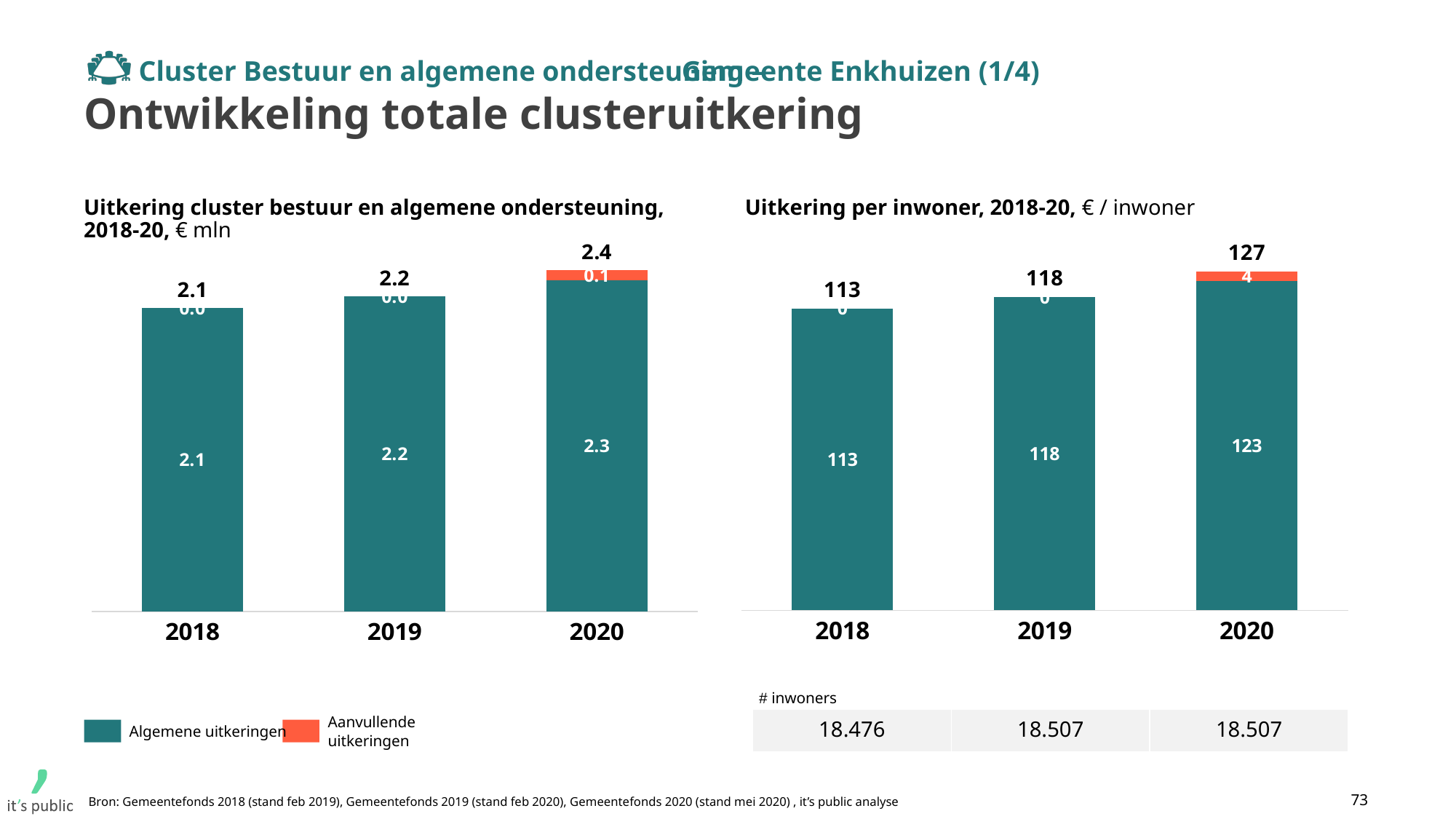
In the left chart (Uitkering cluster bestuur en algemene ondersteuning), what is the total value for 2020? 2.4 In the right chart (Uitkering per inwoner), what is the difference between the totals for 2019 and 2018? 5 In the left chart (Uitkering cluster bestuur en algemene ondersteuning), do the totals rise or fall from 2018 to 2020? rise In the left chart (Uitkering cluster bestuur en algemene ondersteuning), what is the Aanvullende uitkeringen value for 2020? 0.1 In the right chart (Uitkering per inwoner), which year has the lowest total? 2018 In the left chart (Uitkering cluster bestuur en algemene ondersteuning), which year has the highest total? 2020 In the right chart (Uitkering per inwoner), what is the total value for 2020? 127 In the left chart (Uitkering cluster bestuur en algemene ondersteuning), what is the Algemene uitkeringen value for 2019? 2.2 In the right chart (Uitkering per inwoner), what is the Algemene uitkeringen value for 2020? 123 How many series does the legend list? 2 What kind of chart is the left chart (Uitkering cluster bestuur en algemene ondersteuning)? stacked bar chart In the right chart (Uitkering per inwoner), what is the Aanvullende uitkeringen value for 2020? 4